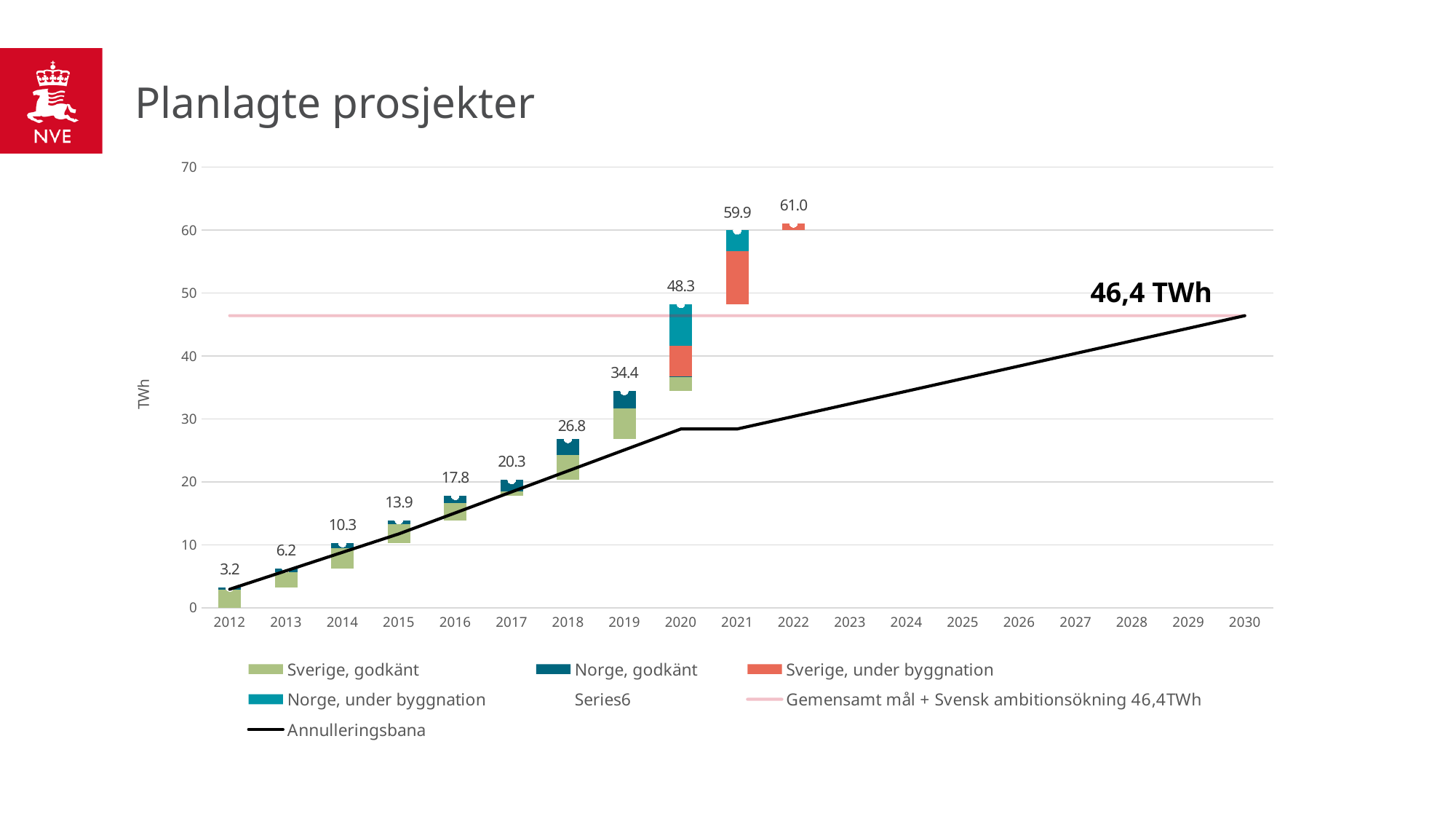
Is the value of the Annulleringsbana line at 2020 greater or less than 30? less Which year has the lowest labelled value? 2012 What value is labelled above the bar for 2015? 13.9 What value is labelled above the bar for 2022? 61.0 What is the difference between the labelled values for 2020 and 2019? 13.9 What is the title of the slide? Planlagte prosjekter How many entries does the legend list? 7 How many years have a labelled bar value? 11 What value is labelled above the bar for 2020? 48.3 What is the difference between the labelled values for 2022 and 2021? 1.1 Which year has the highest labelled value? 2022 Which is larger, the labelled value for 2018 or for 2017? 2018